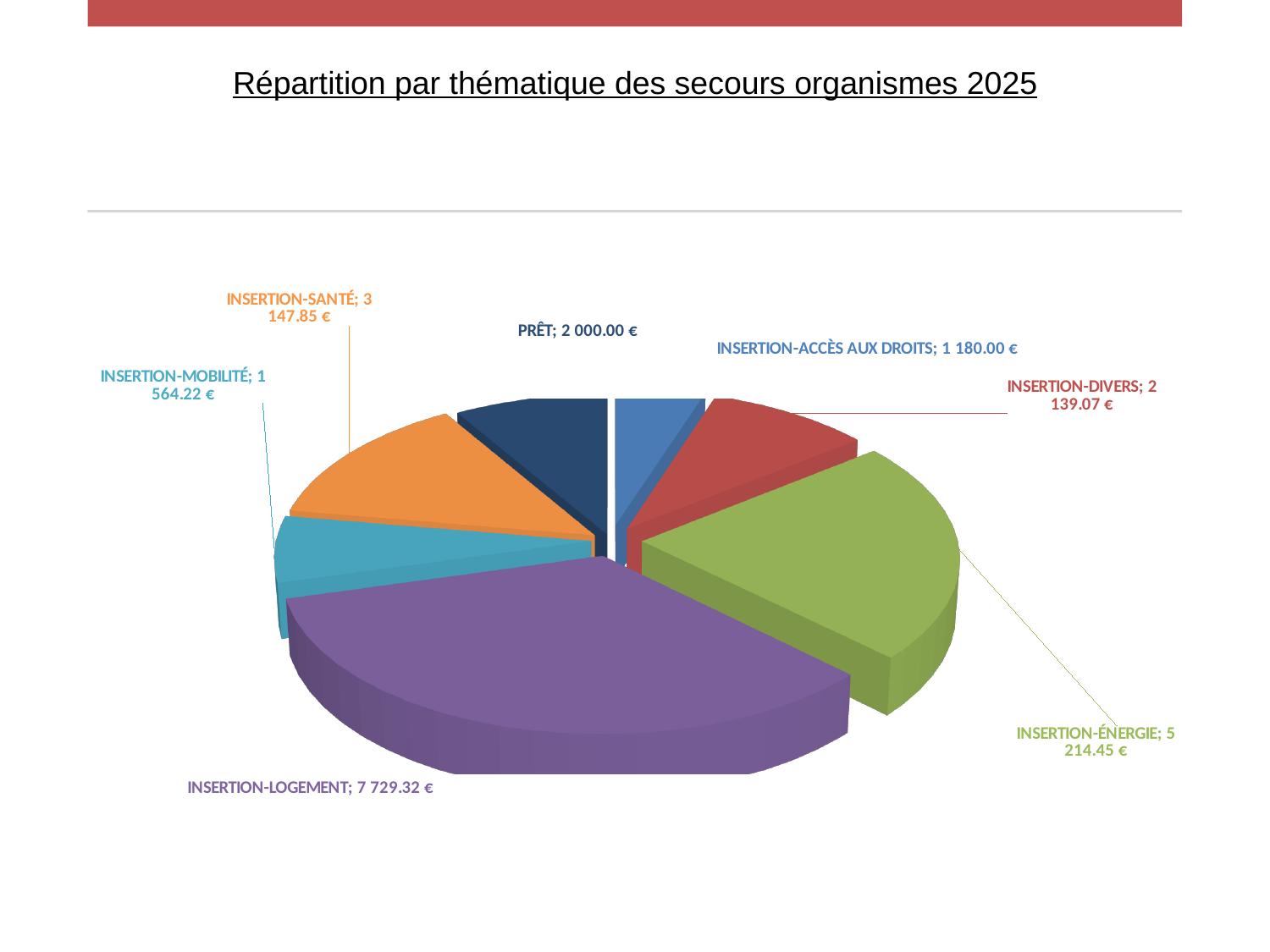
What is the value for INSERTION-LOGEMENT? 7 729.32 € What is the difference between INSERTION-SANTÉ and PRÊT? 1 147.85 € What type of chart is shown on the slide? Pie chart What is the value for INSERTION-MOBILITÉ? 1 564.22 € What is the value for PRÊT? 2 000.00 € Which is larger, INSERTION-SANTÉ or INSERTION-DIVERS? INSERTION-SANTÉ How many slices does the pie chart have? 7 Which category has the highest value? INSERTION-LOGEMENT What is the value for INSERTION-ÉNERGIE? 5 214.45 € Which category has the lowest value? INSERTION-ACCÈS AUX DROITS What is the difference between INSERTION-LOGEMENT and INSERTION-ÉNERGIE? 2 514.87 € What is the title of the chart on the slide? Répartition par thématique des secours organismes 2025